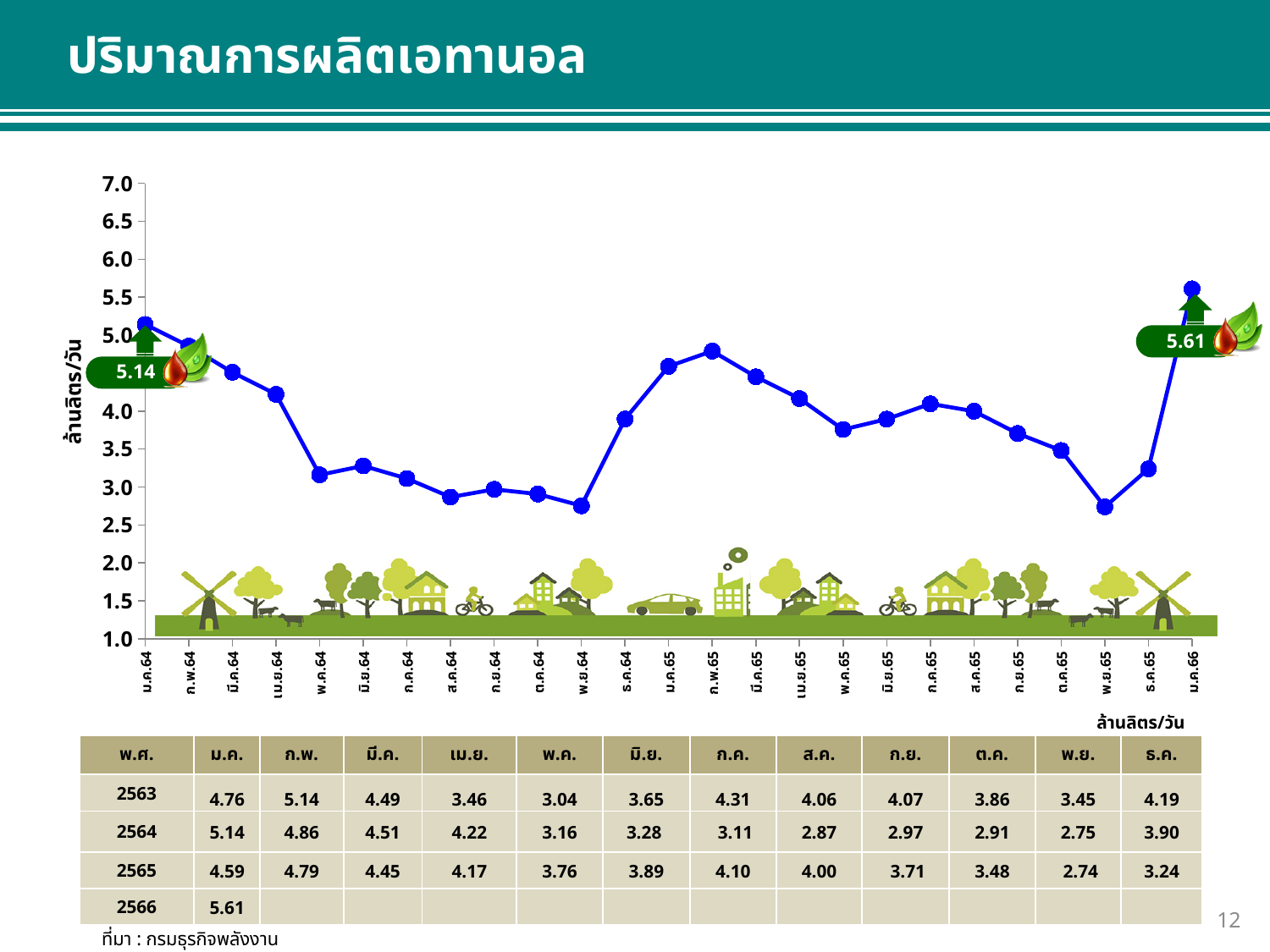
What unit is shown on the y-axis of the chart? ล้านลิตร/วัน What is the difference between the labelled values for ม.ค.66 and ม.ค.64? 0.47 How many data points are plotted on the line chart? 25 Which is larger on the line chart, the value for ม.ค.66 or the value for ม.ค.64? ม.ค.66 What is the value labelled on the chart for ม.ค.64? 5.14 Do the values on the line chart rise or fall from ม.ค.64 to พ.ย.64? fall What is the title of the chart on the slide? ปริมาณการผลิตเอทานอล What type of chart is shown on the slide? line chart Which month has the highest value on the line chart? ม.ค.66 Is the value for ก.พ.65 on the line chart greater or less than 4.5? greater Is the value for ส.ค.64 on the line chart greater or less than 3.0? less What is the value labelled on the chart for ม.ค.66? 5.61